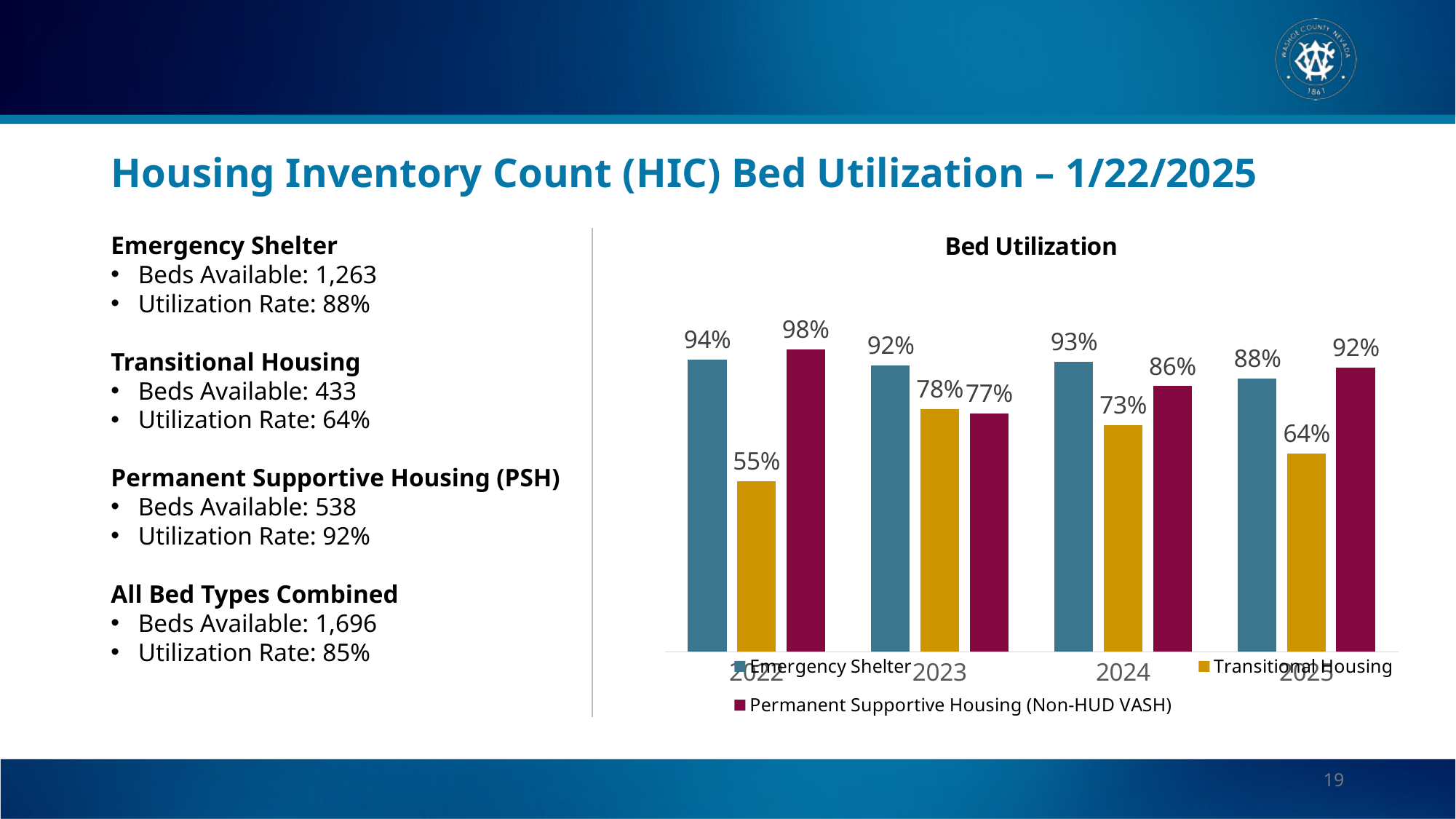
What kind of chart is the Bed Utilization chart? Bar chart What is the Permanent Supportive Housing (Non-HUD VASH) utilization rate for 2024 in the Bed Utilization chart? 86% How many series does the legend of the Bed Utilization chart list? 3 Does the Emergency Shelter utilization rate rise or fall from 2024 to 2025 in the Bed Utilization chart? Fall How many years are shown on the x axis of the Bed Utilization chart? 4 What is the Transitional Housing utilization rate for 2025 in the Bed Utilization chart? 64% In 2023, which series has the higher utilization rate in the Bed Utilization chart: Transitional Housing or Permanent Supportive Housing (Non-HUD VASH)? Transitional Housing In which year is the Permanent Supportive Housing (Non-HUD VASH) utilization rate highest in the Bed Utilization chart? 2022 In which year is the Transitional Housing utilization rate lowest in the Bed Utilization chart? 2022 What is the difference between the Emergency Shelter and Transitional Housing utilization rates in 2022 in the Bed Utilization chart? 39% What is the title of the chart on the slide? Bed Utilization What is the Emergency Shelter utilization rate for 2022 in the Bed Utilization chart? 94%